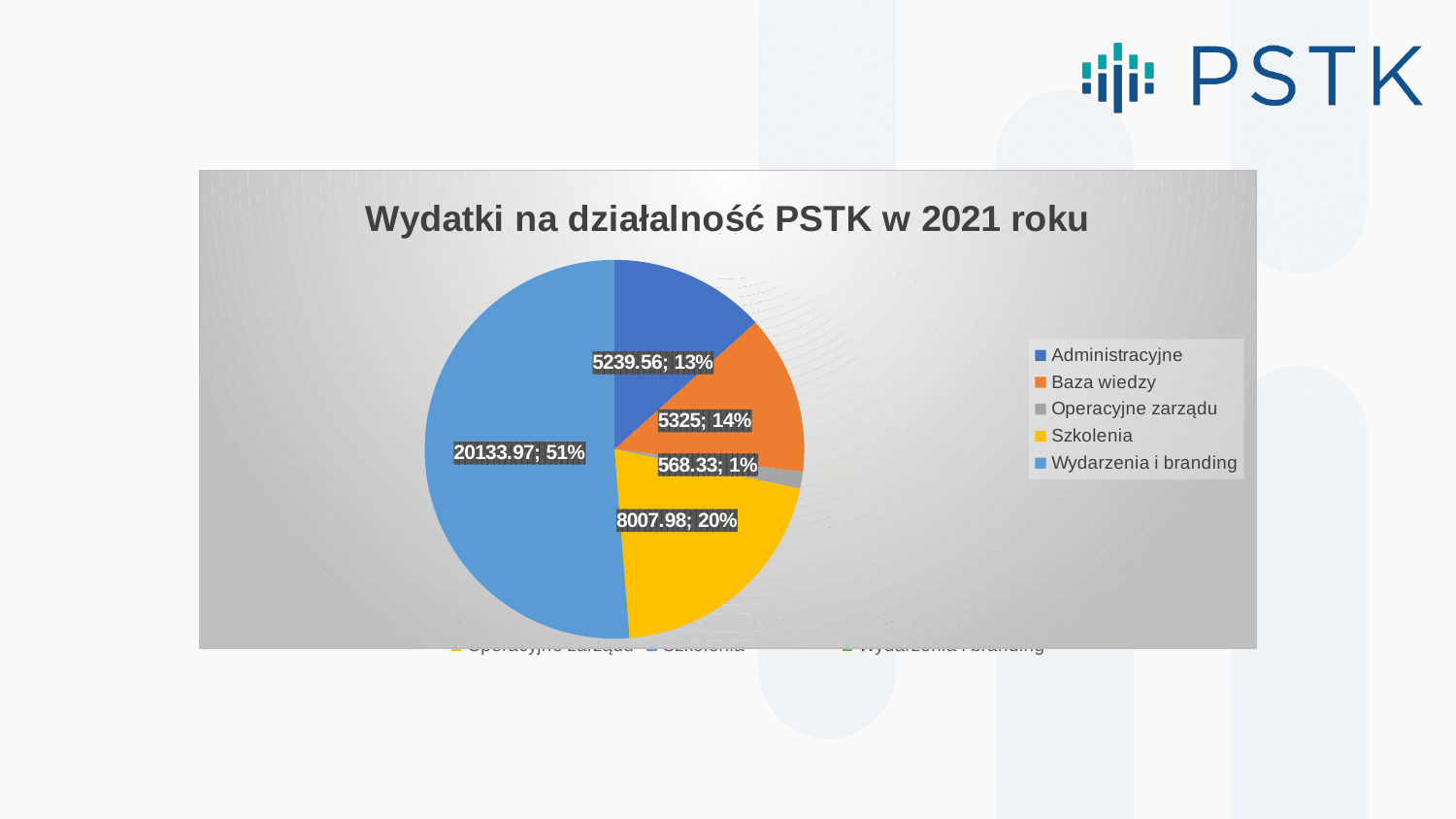
What is the value for Wydarzenia i branding? 20133.97 Which category has the smallest slice? Operacyjne zarządu What is the title of the chart? Wydatki na działalność PSTK w 2021 roku What kind of chart is shown on the slide? pie chart What is the value for Szkolenia? 8007.98 What is the difference between the values for Wydarzenia i branding and Szkolenia? 12125.99 What share of the pie does Baza wiedzy represent? 14% How many categories does the legend list? 5 What share of the pie does Administracyjne represent? 13% Which is larger, the value for Baza wiedzy or the value for Administracyjne? Baza wiedzy What is the value for Operacyjne zarządu? 568.33 Which category has the largest slice? Wydarzenia i branding